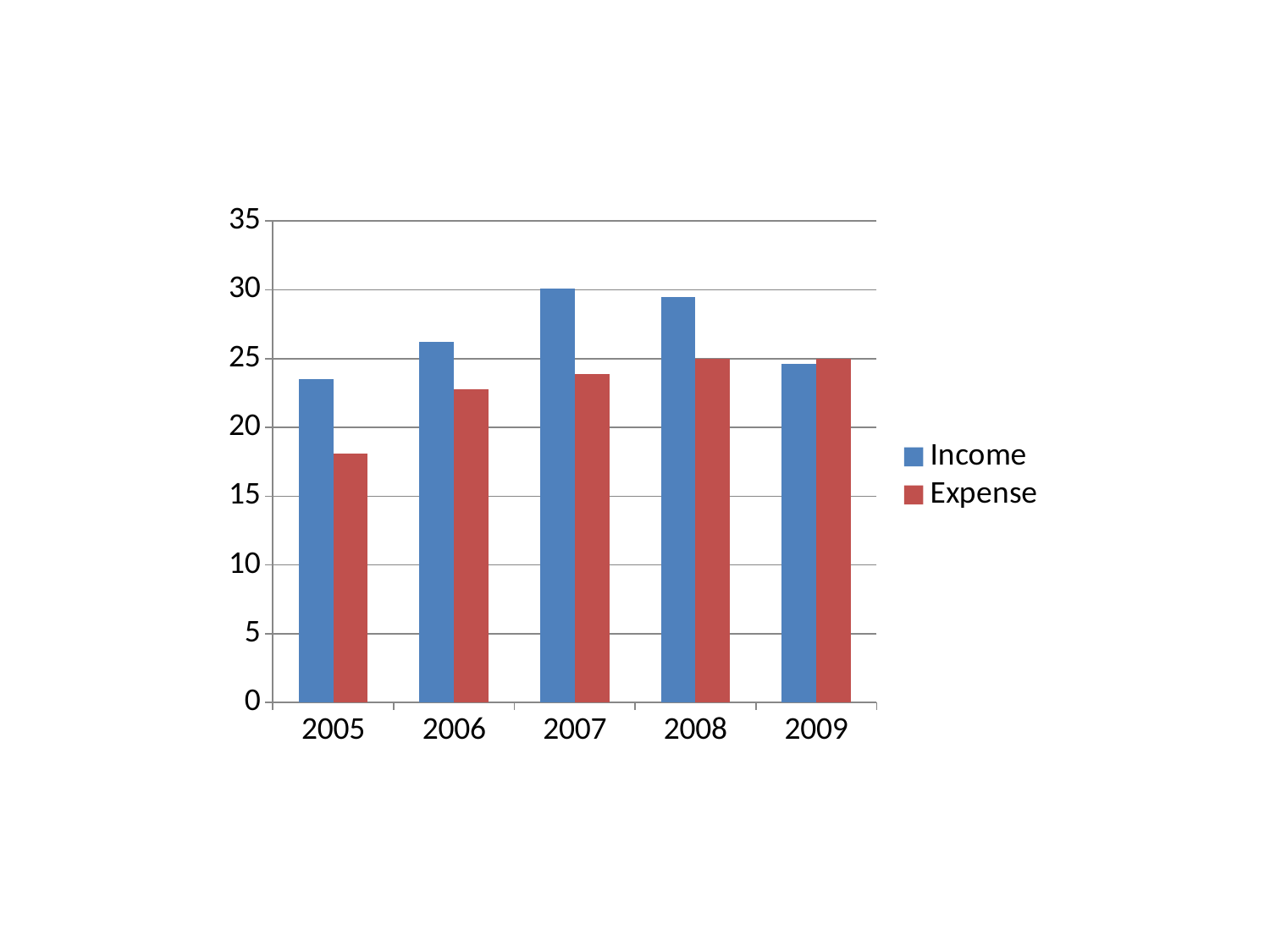
Is the Expense value for 2005 greater or less than 20? less In 2007, which is larger, Income or Expense? Income Is the Income value for 2006 greater or less than 25? greater Does Expense rise or fall from 2005 to 2008? rise How many years are shown on the x axis? 5 Which series is shown in red? Expense How many series does the legend list? 2 Which year has the highest Income? 2007 In 2005, which is larger, Income or Expense? Income What kind of chart is shown on the slide? bar chart Which year has the lowest Expense? 2005 Is the Expense value for 2007 greater or less than 25? less